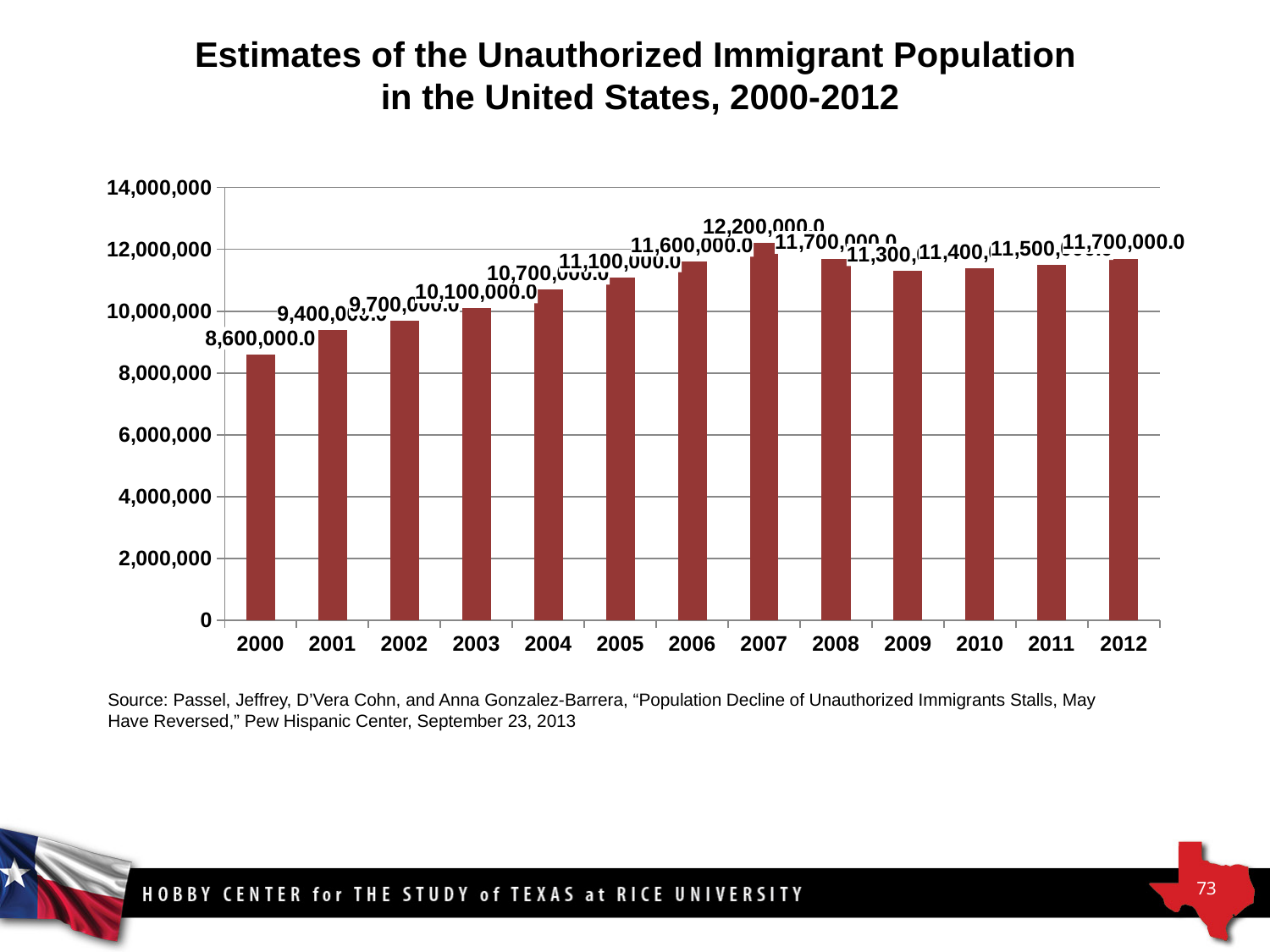
What is the estimated unauthorized immigrant population for 2004? 10,700,000.0 Is the value for 2009 greater or less than 10,000,000? greater Which year has a larger estimate, 2006 or 2008? 2008 Which year has the highest estimated unauthorized immigrant population? 2007 What is the estimated unauthorized immigrant population for 2012? 11,700,000.0 What kind of chart is shown on the slide? bar chart Which year has the lowest estimated unauthorized immigrant population? 2000 Do the values rise or fall from 2000 to 2007? rise How many years are shown on the x axis of the chart? 13 What is the estimated unauthorized immigrant population for 2000? 8,600,000.0 What is the estimated unauthorized immigrant population for 2007? 12,200,000.0 What is the difference between the estimates for 2007 and 2000? 3,600,000.0